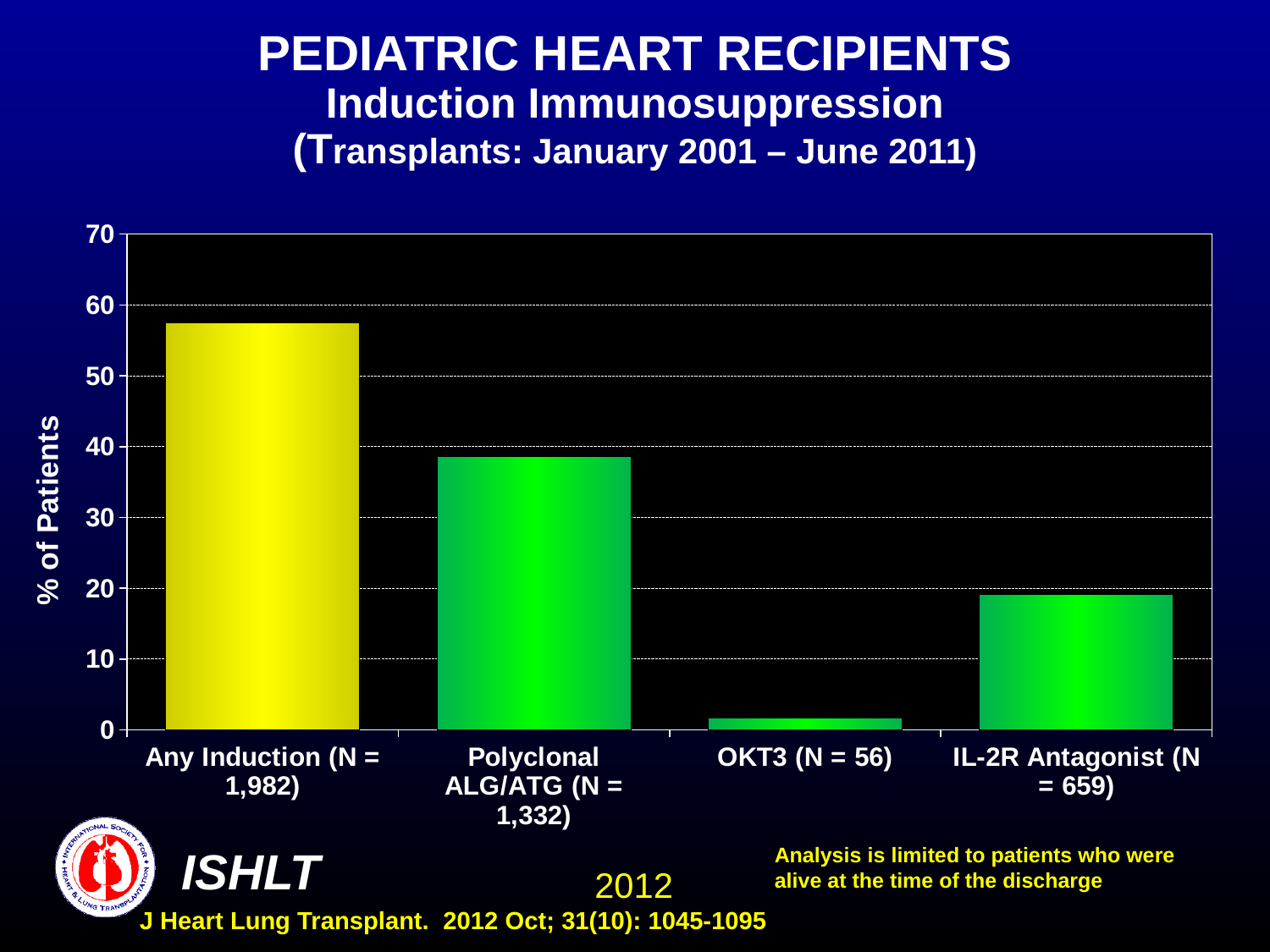
Is the value for Any Induction (N = 1,982) greater or less than 50? greater Is the value for Polyclonal ALG/ATG (N = 1,332) greater or less than 40? less Which category has the lowest % of patients? OKT3 (N = 56) What kind of chart is shown on the slide? bar chart What is the label of the y axis of the chart? % of Patients How many categories are shown on the x axis of the chart? 4 Is the value for Polyclonal ALG/ATG (N = 1,332) greater or less than 30? greater Which category has the highest % of patients? Any Induction (N = 1,982) Which is larger, the value for Polyclonal ALG/ATG (N = 1,332) or the value for IL-2R Antagonist (N = 659)? Polyclonal ALG/ATG (N = 1,332)